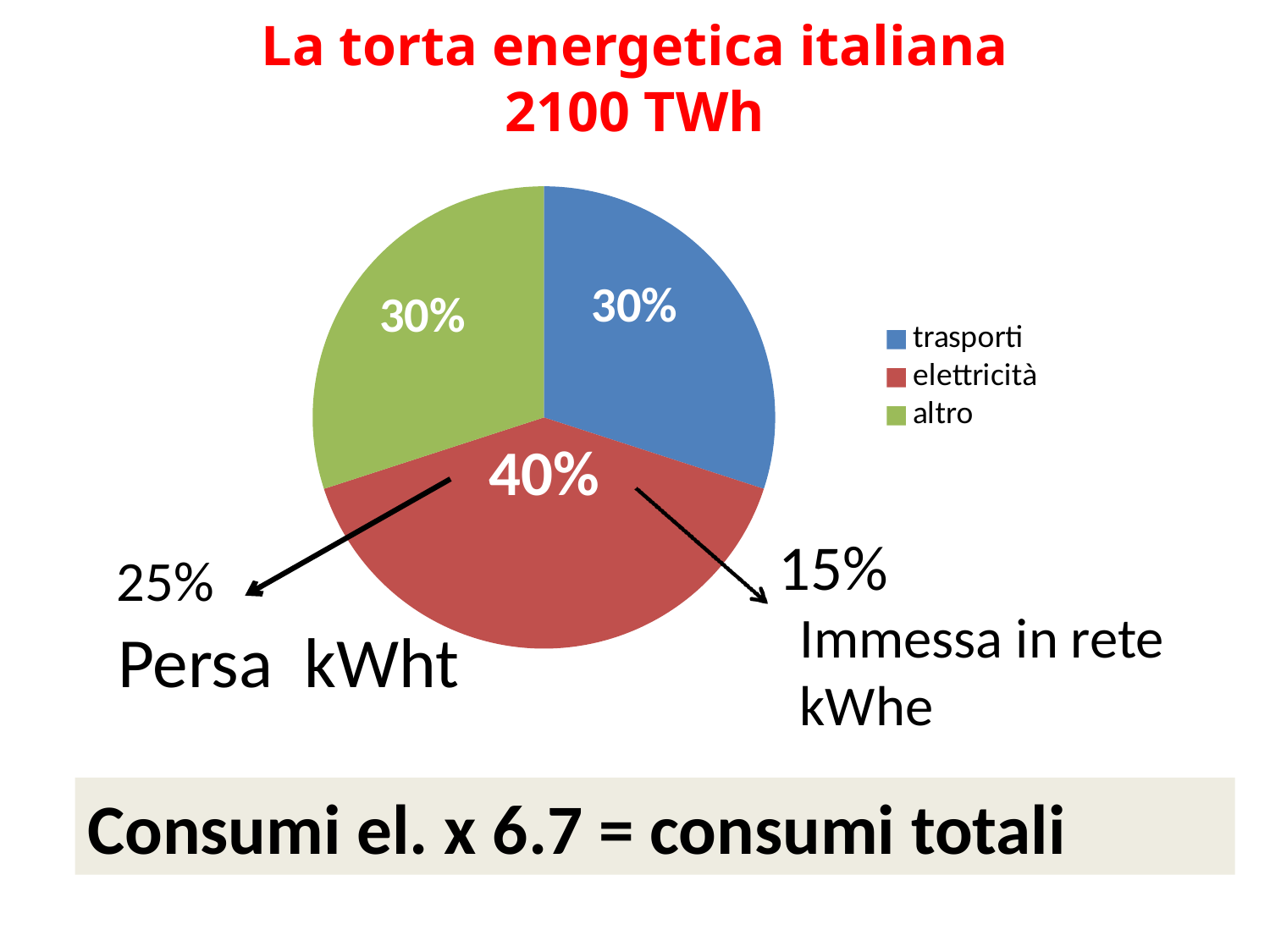
Which is larger, the 'elettricità' slice or the 'altro' slice? elettricità How many entries does the legend list? 3 What share of the pie does the 'trasporti' slice represent? 30% What share of the pie does the 'altro' slice represent? 30% What kind of chart is shown on the slide? pie chart Which category has the largest slice of the pie? elettricità What share of the pie does the 'elettricità' slice represent? 40% What colour is the 'elettricità' slice? red How many slices does the pie chart have? 3 What is the title of the chart? La torta energetica italiana 2100 TWh What is the combined share of the 'trasporti' and 'altro' slices? 60% What is the difference in percentage points between the 'elettricità' slice and the 'trasporti' slice? 10%